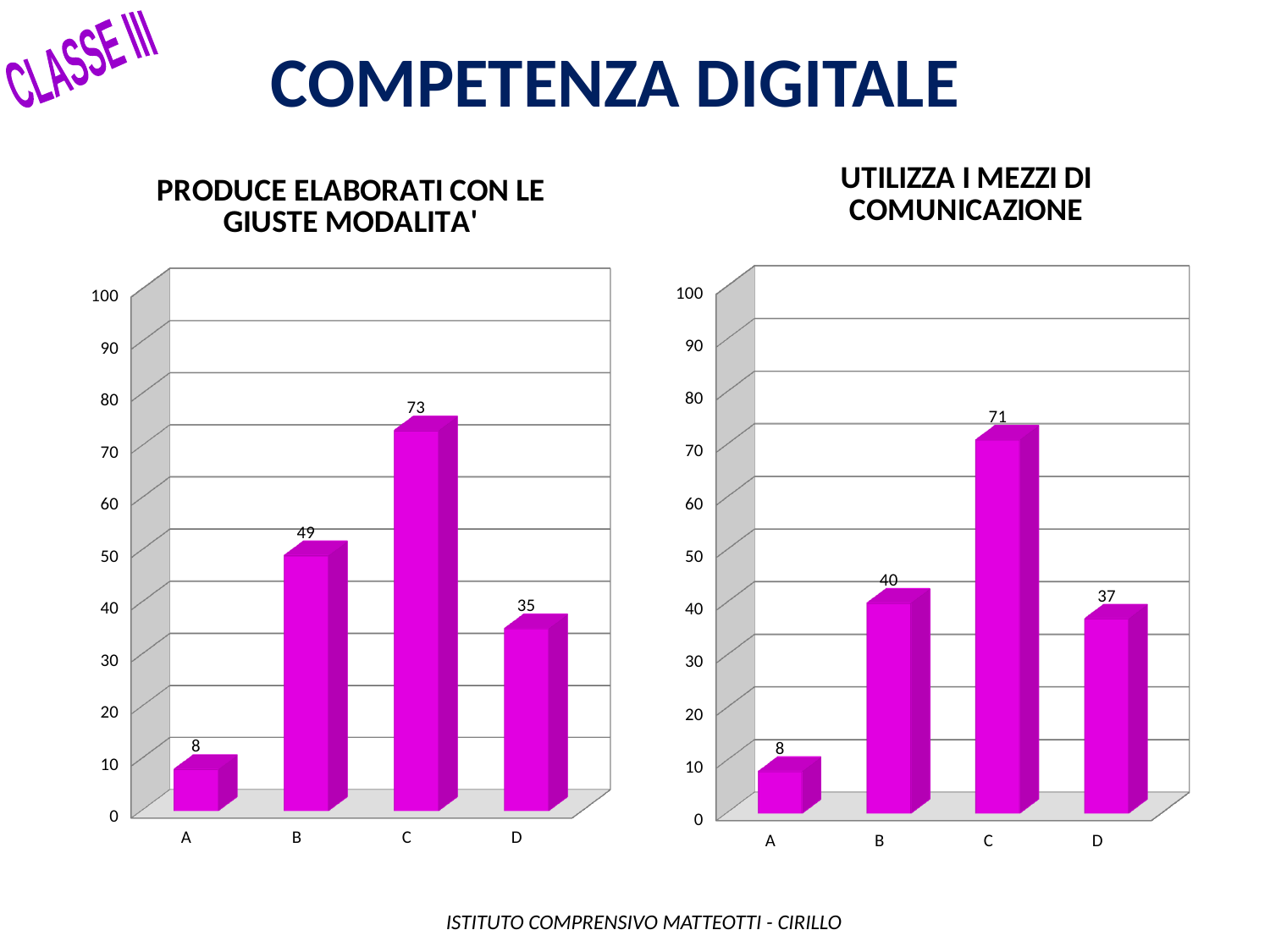
How many categories are shown in the chart titled 'UTILIZZA I MEZZI DI COMUNICAZIONE'? 4 In the chart titled 'UTILIZZA I MEZZI DI COMUNICAZIONE', what is the value for category D? 37 In the chart titled 'UTILIZZA I MEZZI DI COMUNICAZIONE', what is the value for category B? 40 In the chart titled 'UTILIZZA I MEZZI DI COMUNICAZIONE', what is the difference between the values for C and A? 63 In the chart titled 'PRODUCE ELABORATI CON LE GIUSTE MODALITA'', which category has the highest value? C What colour are the bars in the chart titled 'PRODUCE ELABORATI CON LE GIUSTE MODALITA''? Magenta In the chart titled 'PRODUCE ELABORATI CON LE GIUSTE MODALITA'', what is the value for category C? 73 In the chart titled 'UTILIZZA I MEZZI DI COMUNICAZIONE', which category has the lowest value? A In the chart titled 'PRODUCE ELABORATI CON LE GIUSTE MODALITA'', is the value for D greater or less than 40? less What kind of chart is the chart titled 'PRODUCE ELABORATI CON LE GIUSTE MODALITA''? Bar chart In the chart titled 'PRODUCE ELABORATI CON LE GIUSTE MODALITA'', what is the difference between the values for B and D? 14 In the chart titled 'UTILIZZA I MEZZI DI COMUNICAZIONE', which is larger, the value for B or the value for D? B